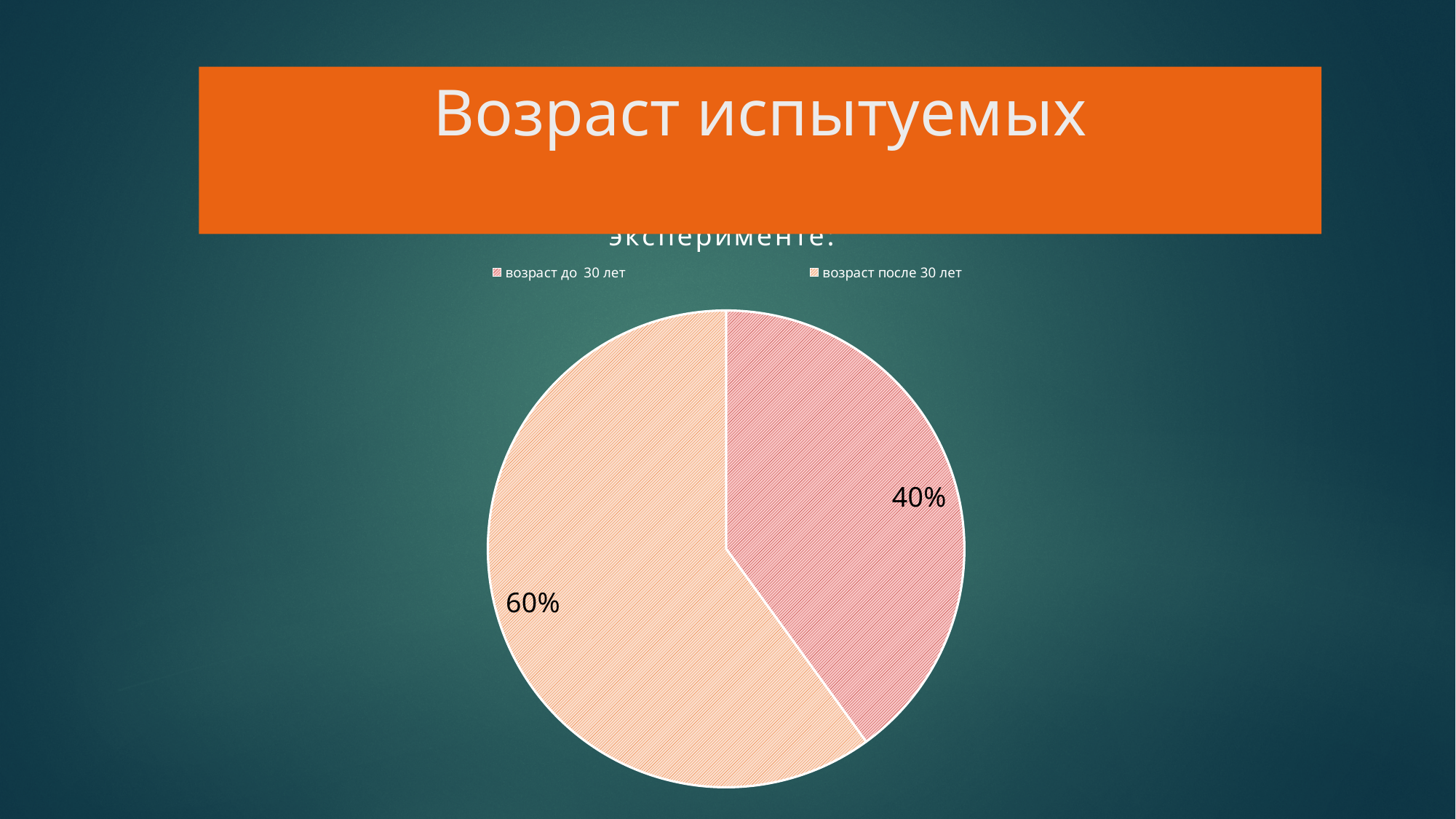
What is the data label printed on the pink slice of the pie? 40% How many slices does the pie chart have? 2 What is the title shown in the orange banner at the top of the slide? Возраст испытуемых Which category has the largest slice of the pie? возраст после 30 лет Which is larger: the slice for "возраст до 30 лет" or the slice for "возраст после 30 лет"? возраст после 30 лет What share of the pie does "возраст после 30 лет" take? 60% What is the difference in percentage points between the "возраст после 30 лет" slice and the "возраст до 30 лет" slice? 20 percentage points How many entries does the legend list? 2 Which category has the smallest slice of the pie? возраст до 30 лет What share of the pie does "возраст до 30 лет" take? 40% Is the share for "возраст до 30 лет" greater or less than 50%? less What kind of chart is shown on the slide? pie chart